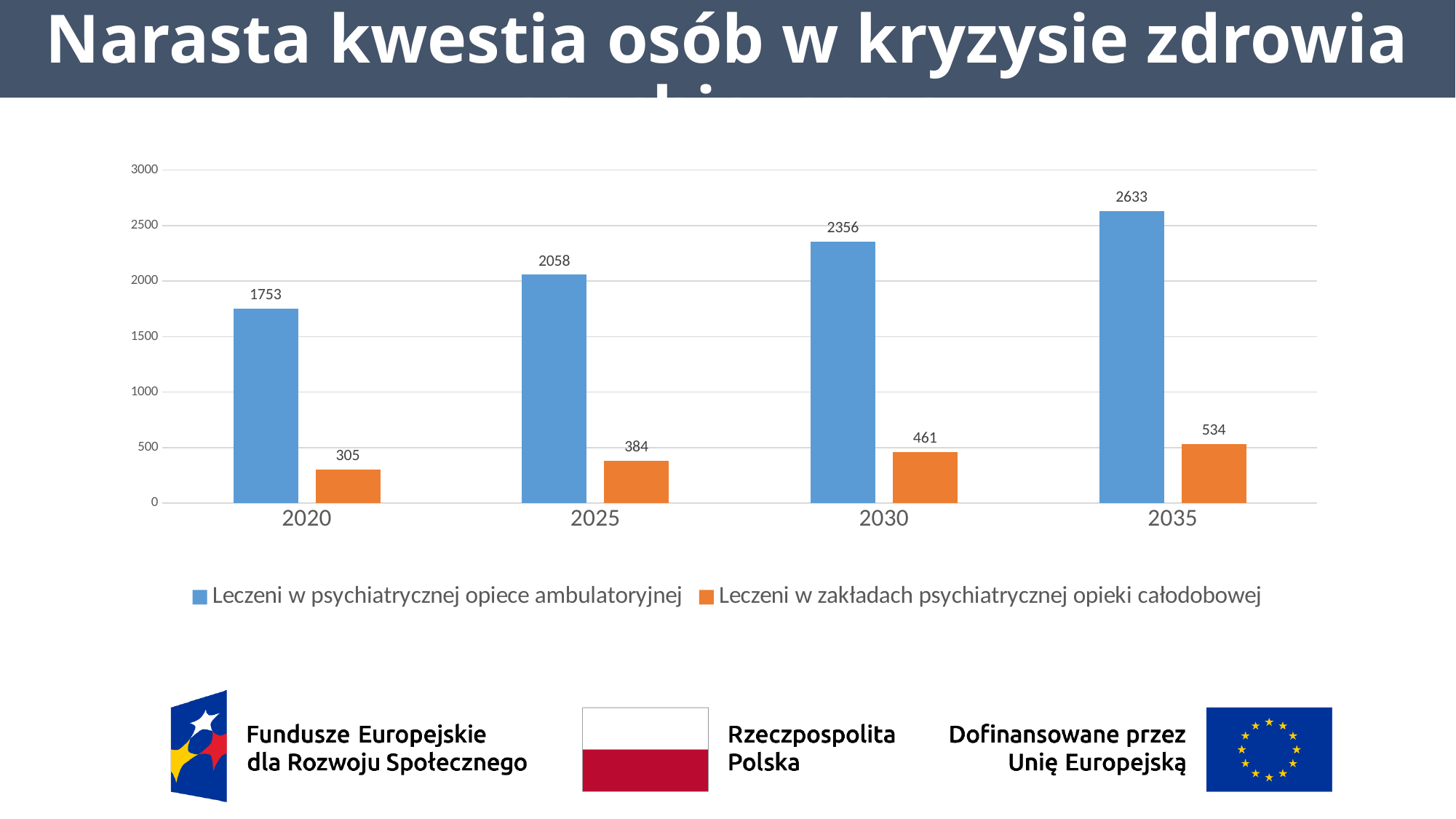
How many series does the legend list? 2 Which is larger in 2030: 'Leczeni w psychiatrycznej opiece ambulatoryjnej' or 'Leczeni w zakładach psychiatrycznej opieki całodobowej'? Leczeni w psychiatrycznej opiece ambulatoryjnej What is the value for 'Leczeni w zakładach psychiatrycznej opieki całodobowej' in 2035? 534 In which year is the value for 'Leczeni w psychiatrycznej opiece ambulatoryjnej' highest? 2035 What is the value for 'Leczeni w psychiatrycznej opiece ambulatoryjnej' in 2020? 1753 What is the value for 'Leczeni w zakładach psychiatrycznej opieki całodobowej' in 2025? 384 What is the difference between the 'Leczeni w zakładach psychiatrycznej opieki całodobowej' values for 2030 and 2025? 77 What kind of chart is shown on the slide? bar chart In which year is the value for 'Leczeni w zakładach psychiatrycznej opieki całodobowej' lowest? 2020 What is the difference between the 'Leczeni w psychiatrycznej opiece ambulatoryjnej' values for 2035 and 2020? 880 How many years are shown on the x axis? 4 Do the values for 'Leczeni w psychiatrycznej opiece ambulatoryjnej' rise or fall from 2020 to 2035? rise